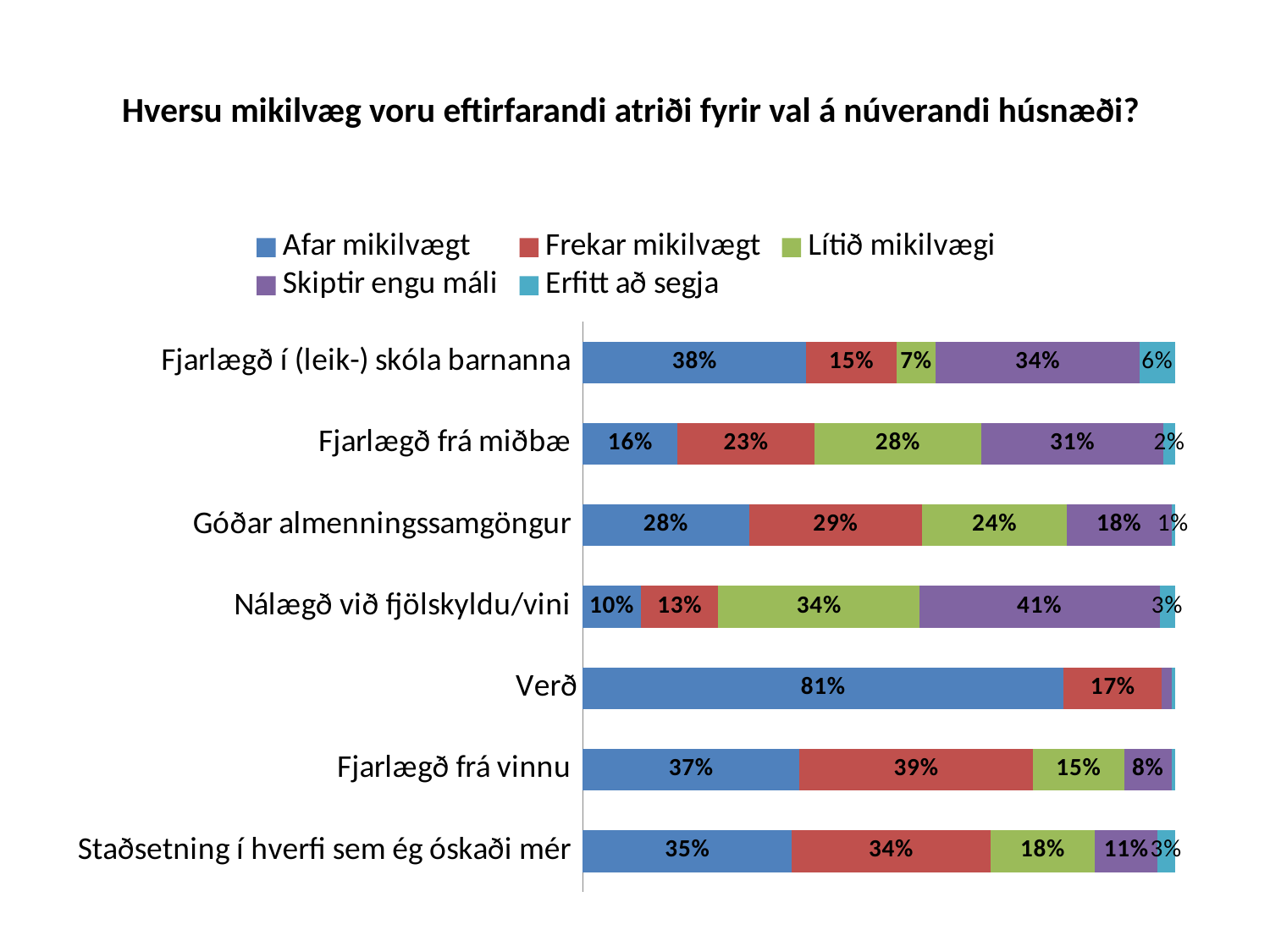
What is the 'Afar mikilvægt' value for 'Verð'? 81% What is the difference between the 'Frekar mikilvægt' values for 'Fjarlægð frá vinnu' and 'Fjarlægð í (leik-) skóla barnanna'? 24% What is the 'Lítið mikilvægi' value for 'Fjarlægð frá miðbæ'? 28% Which category has the highest 'Afar mikilvægt' value? Verð Which is larger: the 'Skiptir engu máli' value for 'Fjarlægð frá miðbæ' or for 'Góðar almenningssamgöngur'? Fjarlægð frá miðbæ How many series does the legend list? 5 Which category has the lowest 'Afar mikilvægt' value? Nálægð við fjölskyldu/vini What is the total of the stacked bar for 'Fjarlægð í (leik-) skóla barnanna'? 100% What kind of chart is shown on the slide? stacked bar chart How many categories are plotted on the chart? 7 What is the 'Skiptir engu máli' value for 'Nálægð við fjölskyldu/vini'? 41% What is the title of the chart? Hversu mikilvæg voru eftirfarandi atriði fyrir val á núverandi húsnæði?